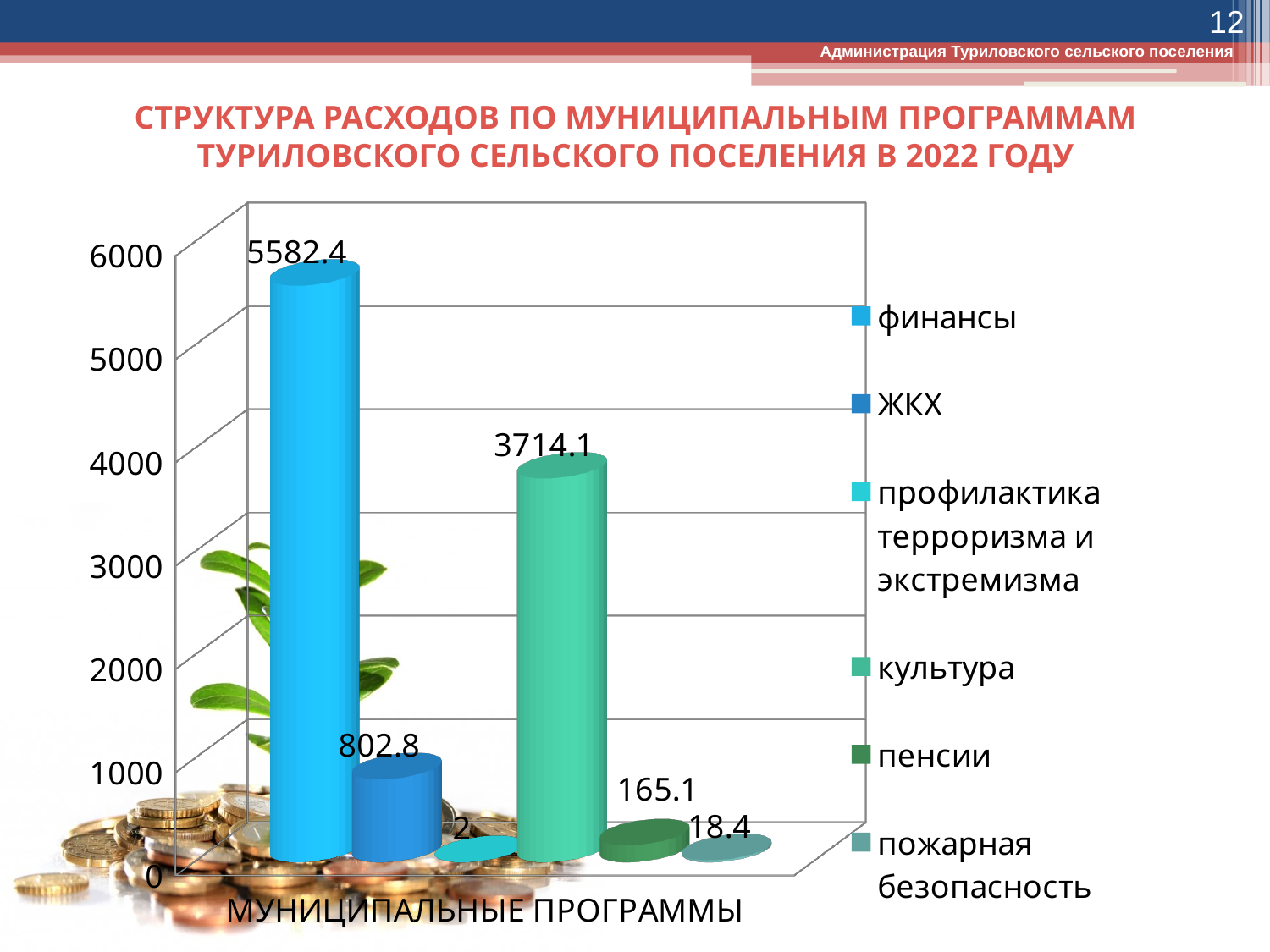
What is the value for пенсии? 165.1 Which is larger, the value for ЖКХ or the value for пенсии? ЖКХ What is the difference between the values for финансы and культура? 1868.3 What is the value for финансы? 5582.4 What is the value for культура? 3714.1 Which series has the lowest value? профилактика терроризма и экстремизма What kind of chart is shown on the slide? bar chart How many series does the legend list? 6 Which series has the highest value? финансы What is the label on the horizontal axis of the chart? МУНИЦИПАЛЬНЫЕ ПРОГРАММЫ What is the value for пожарная безопасность? 18.4 What is the value for ЖКХ? 802.8